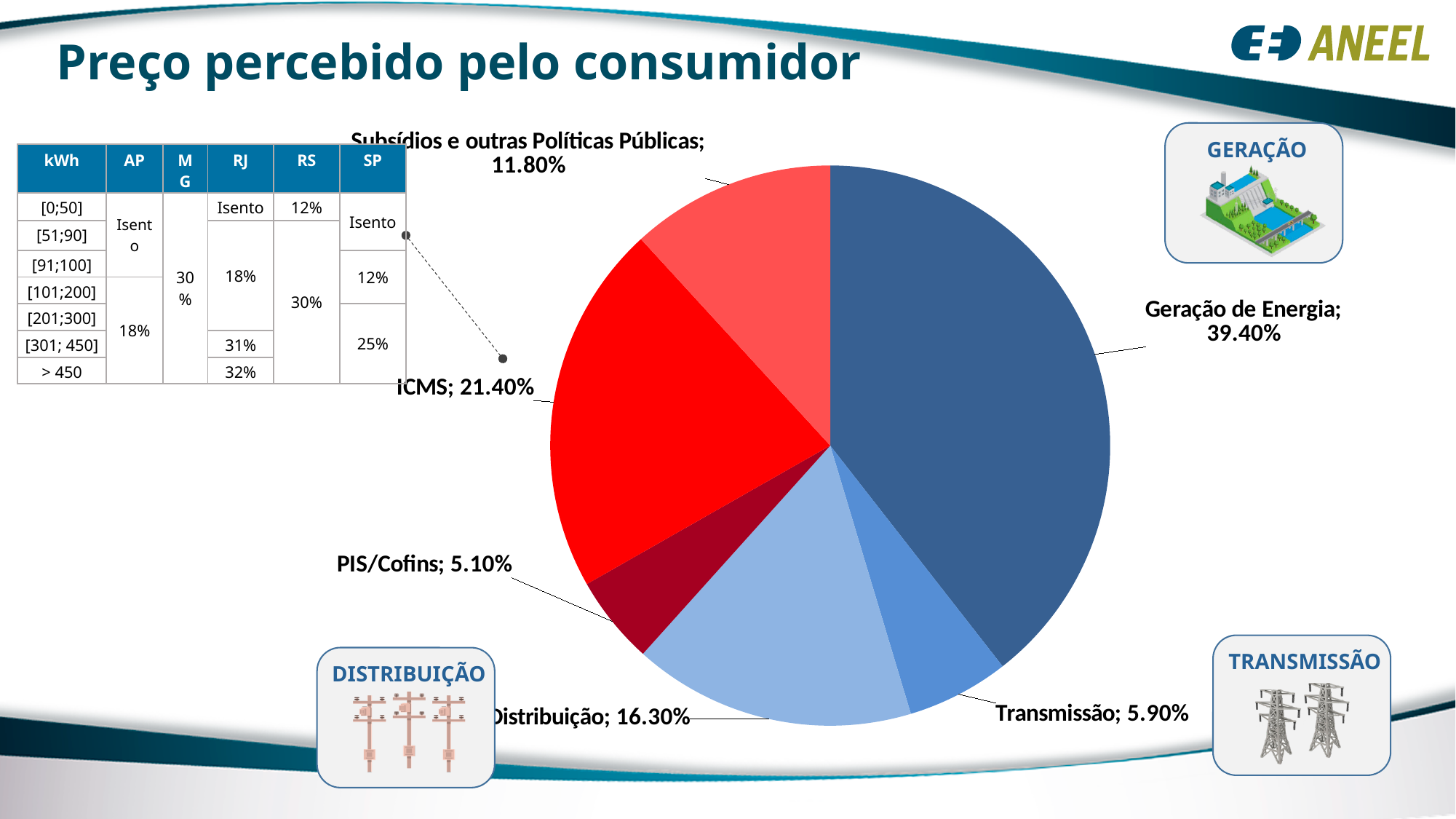
What is the combined share of ICMS and PIS/Cofins? 26.50% What is the difference between the ICMS share and the Distribuição share? 5.10% Which is larger, the share for Transmissão or the share for PIS/Cofins? Transmissão What is the value shown for Distribuição? 16.30% What is the value shown for Subsídios e outras Políticas Públicas? 11.80% What share of the pie does Geração de Energia represent? 39.40% Which slice of the pie chart is the largest? Geração de Energia Which slice of the pie chart is the smallest? PIS/Cofins What is the value shown for ICMS? 21.40% How many slices does the pie chart have? 6 What is the value shown for Transmissão? 5.90% What kind of chart is shown on the slide? Pie chart